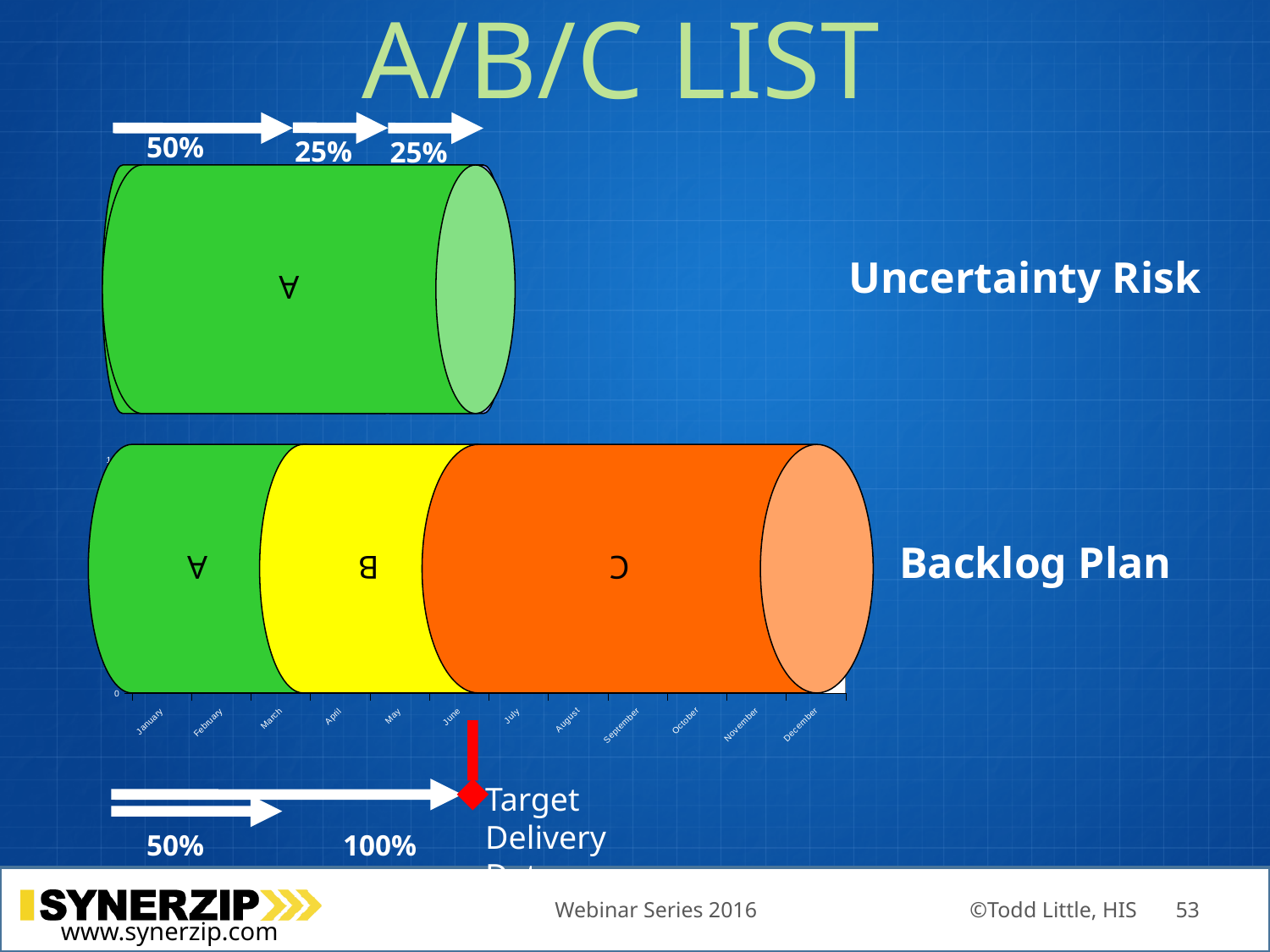
What kind of chart is the Backlog Plan chart? bar chart In the Backlog Plan chart, which month does the red Target Delivery Date marker point to? June In the Backlog Plan chart, which segment is larger, A or C? C What is the first month labelled on the x axis of the Backlog Plan chart? January In the Backlog Plan chart, which segment (A, B or C) spans the widest range of months? C In the Backlog Plan chart, how many labelled segments (A, B, C) make up the bar? 3 What is the last month labelled on the x axis of the Backlog Plan chart? December What colour is segment B in the Backlog Plan chart? yellow What are the three percentages shown above the Uncertainty Risk cylinder, from left to right? 50%, 25%, 25% In the Backlog Plan chart, how many months are labelled along the x axis? 12 Which segment label appears in the Uncertainty Risk cylinder? A